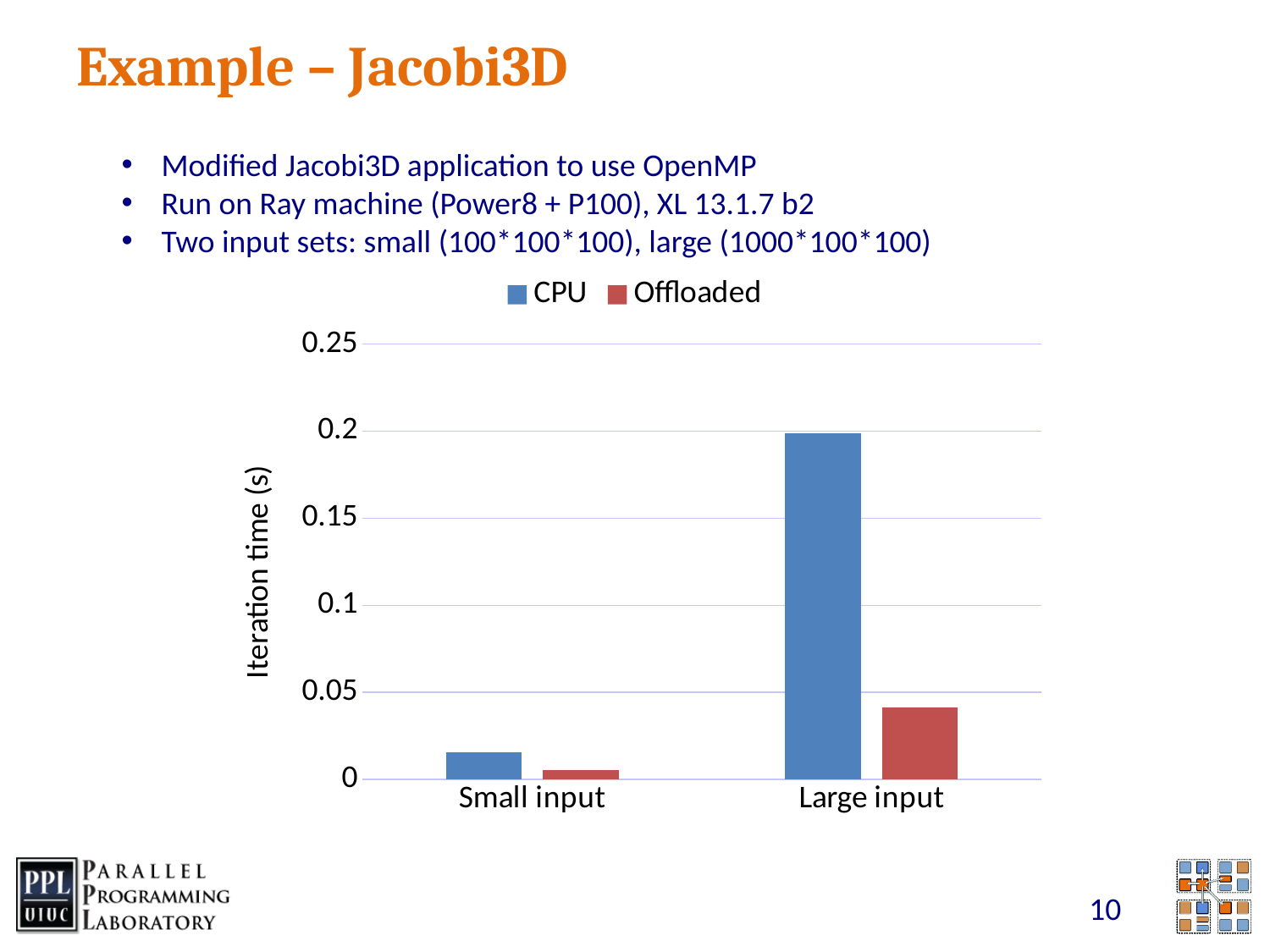
What are the two series named in the chart's legend? CPU and Offloaded What kind of chart is shown on the slide? bar chart For Small input, which is larger: the CPU iteration time or the Offloaded iteration time? CPU Is the Offloaded iteration time for Large input greater or less than 0.05? less How many input categories are shown on the x axis of the chart? 2 What is the label of the y axis of the chart? Iteration time (s) Which series and category has the lowest iteration time in the chart? Offloaded, Small input Is the CPU iteration time for Large input greater or less than 0.15? greater How many series does the chart's legend list? 2 Is the CPU iteration time for Small input greater or less than 0.05? less For Large input, which is larger: the CPU iteration time or the Offloaded iteration time? CPU Which series and category has the highest iteration time in the chart? CPU, Large input